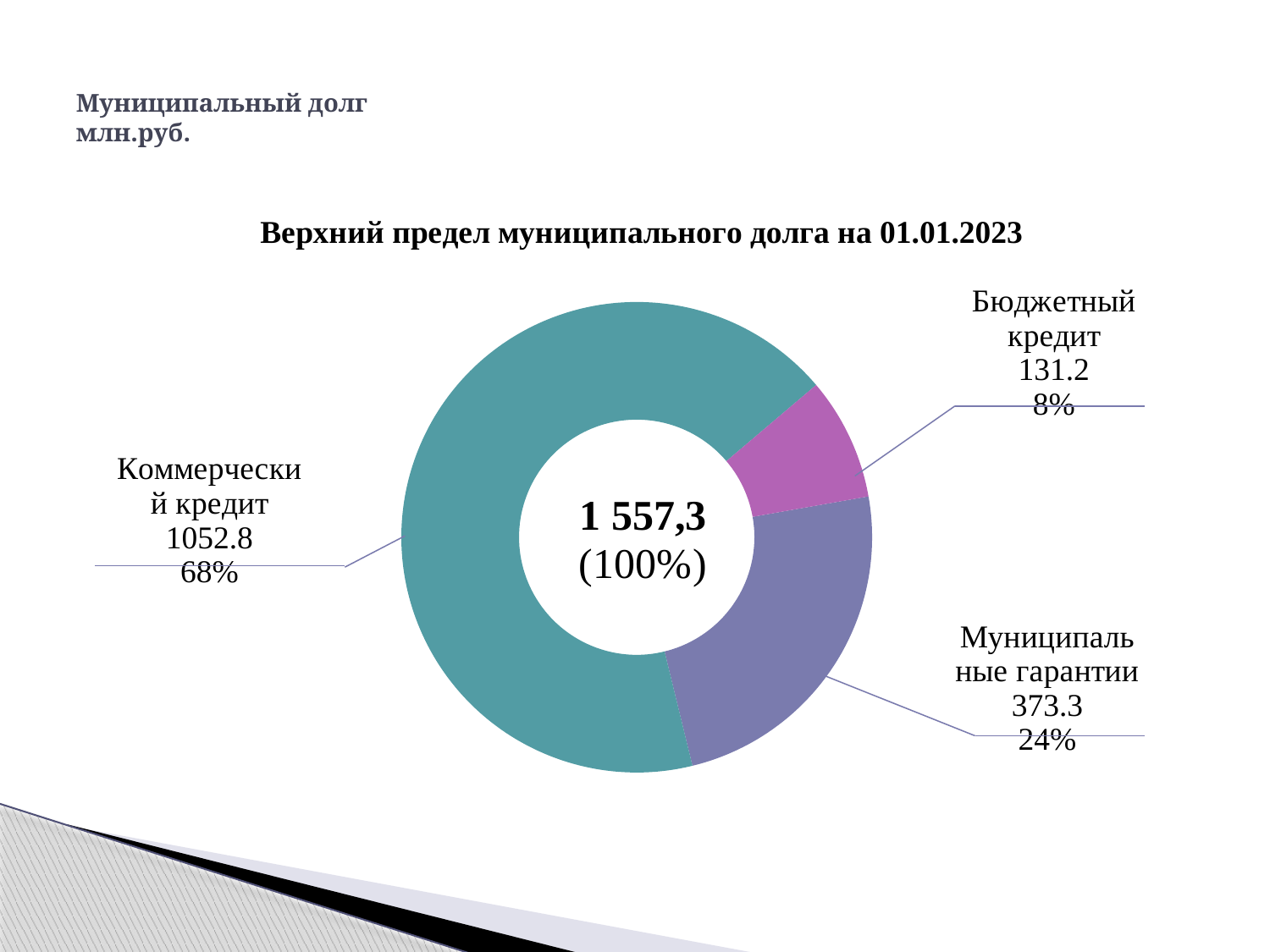
Which category has the largest slice? Коммерческий кредит How many categories are shown in the chart? 3 What total value is shown in the centre of the chart? 1 557,3 (100%) What is the value for Коммерческий кредит? 1052.8 What type of chart is shown on the slide? Doughnut (pie) chart Which category has the smallest slice? Бюджетный кредит What share of the total does Коммерческий кредит represent? 68% What is the value for Бюджетный кредит? 131.2 What share of the total does Муниципальные гарантии represent? 24% What is the title of the chart? Верхний предел муниципального долга на 01.01.2023 What is the difference between the values for Муниципальные гарантии and Бюджетный кредит? 242.1 What is the value for Муниципальные гарантии? 373.3